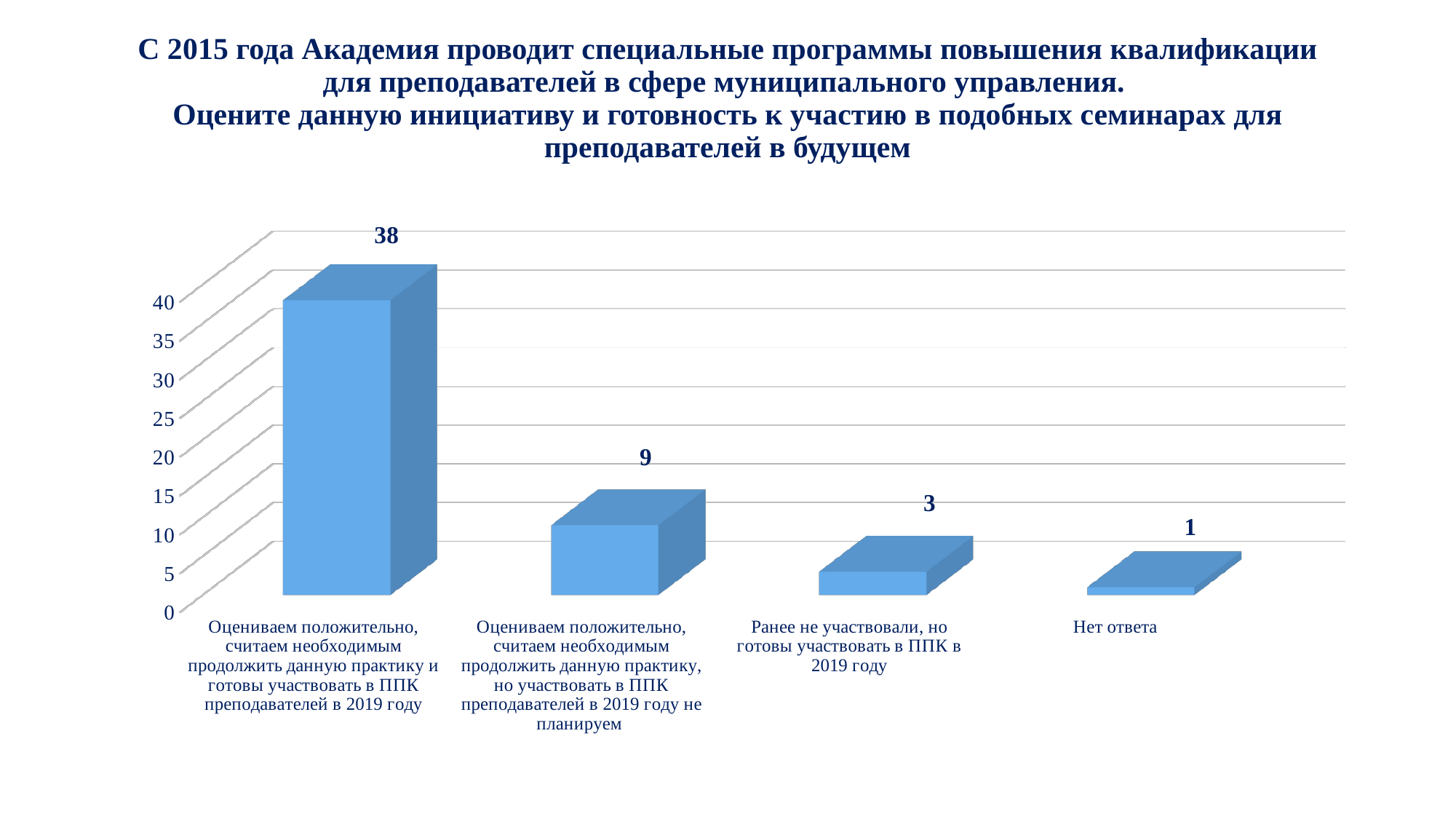
Which category has the lowest value? Нет ответа What is the difference between the values for "Ранее не участвовали, но готовы участвовать в ППК в 2019 году" and "Нет ответа"? 2 Is the value for the first category ("Оцениваем положительно... готовы участвовать в ППК преподавателей в 2019 году") greater or less than 35? greater Which category has the highest value? Оцениваем положительно, считаем необходимым продолжить данную практику и готовы участвовать в ППК преподавателей в 2019 году What kind of chart is shown on the slide? Bar chart What is the value for the category "Нет ответа"? 1 What is the value for "Оцениваем положительно, считаем необходимым продолжить данную практику, но участвовать в ППК преподавателей в 2019 году не планируем"? 9 What is the difference between the highest value (38) and the second-highest value (9)? 29 Which is larger: the value for "Оцениваем положительно, считаем необходимым продолжить данную практику, но участвовать в ППК преподавателей в 2019 году не планируем" or the value for "Ранее не участвовали, но готовы участвовать в ППК в 2019 году"? Оцениваем положительно, считаем необходимым продолжить данную практику, но участвовать в ППК преподавателей в 2019 году не планируем Do the values rise or fall from left to right across the categories? Fall What is the value for "Ранее не участвовали, но готовы участвовать в ППК в 2019 году"? 3 How many categories are shown on the chart? 4